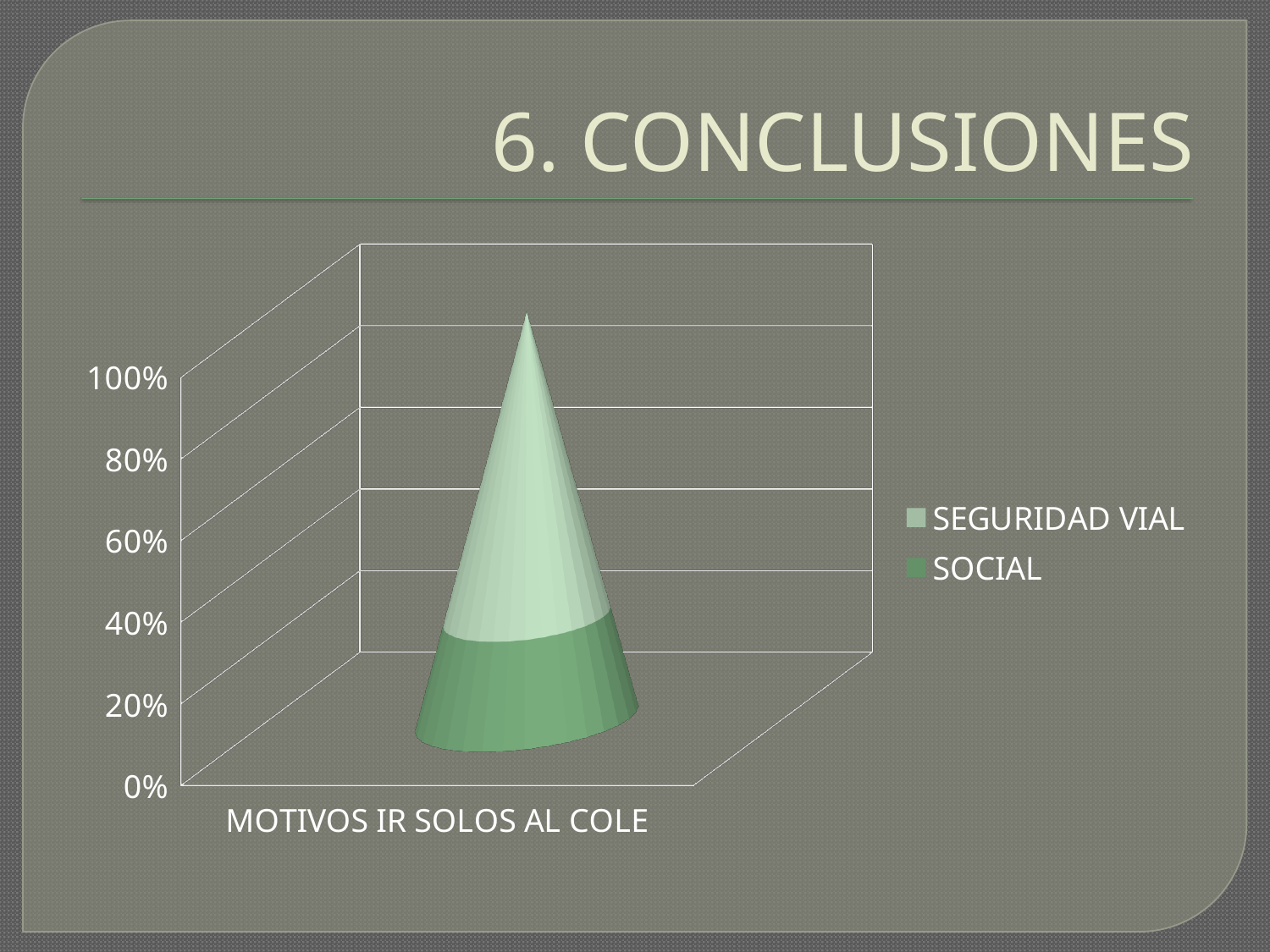
Which series takes up the larger share of the stacked bar, SEGURIDAD VIAL or SOCIAL? SEGURIDAD VIAL Which series has the largest share of the stacked bar? SEGURIDAD VIAL Is the value for SOCIAL greater or less than 40%? less What are the two series named in the legend? SEGURIDAD VIAL and SOCIAL Is the value for SEGURIDAD VIAL greater or less than 60%? greater How many series does the legend list? 2 Which series has the smallest share of the stacked bar? SOCIAL What is the label of the category on the x axis? MOTIVOS IR SOLOS AL COLE How many categories are shown on the x axis? 1 What is the highest value shown on the vertical axis? 100%